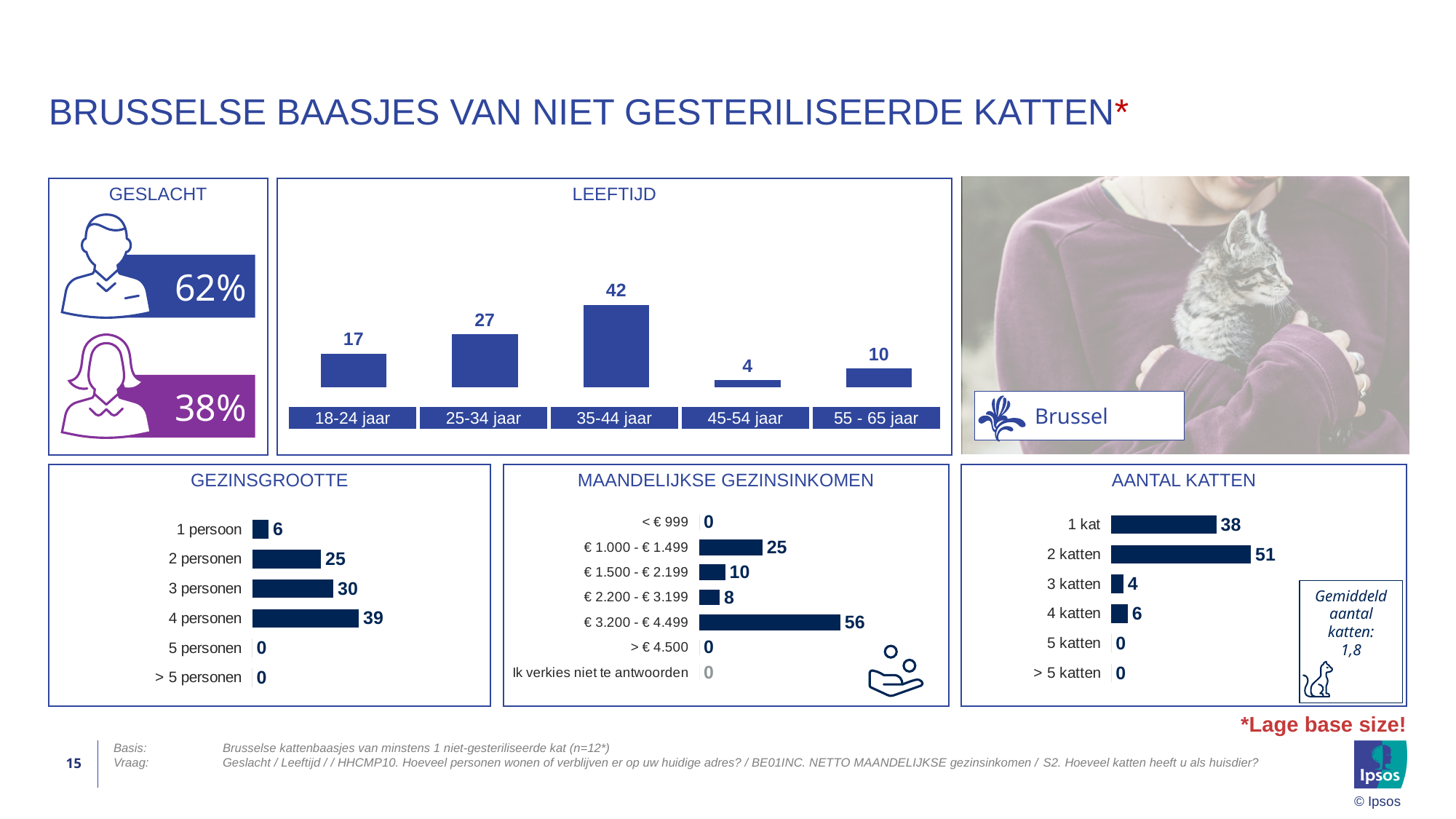
What type of chart is the LEEFTIJD chart? Bar chart In the MAANDELIJKSE GEZINSINKOMEN chart, what is the value for € 3.200 - € 4.499? 56 In the GEZINSGROOTTE chart, which category has the highest value? 4 personen In the LEEFTIJD chart, which age group has the lowest value? 45-54 jaar In the GESLACHT panel, what percentage is shown for the male figure? 62% In the AANTAL KATTEN chart, what is the value for 2 katten? 51 In the GEZINSGROOTTE chart, what is the value for 3 personen? 30 How many age categories are shown in the LEEFTIJD chart? 5 In the AANTAL KATTEN chart, what is the difference between the values for 2 katten and 1 kat? 13 In the LEEFTIJD chart, what is the value for 35-44 jaar? 42 In the LEEFTIJD chart, what is the difference between the values for 35-44 jaar and 25-34 jaar? 15 In the MAANDELIJKSE GEZINSINKOMEN chart, which is larger: the value for € 1.000 - € 1.499 or the value for € 1.500 - € 2.199? € 1.000 - € 1.499